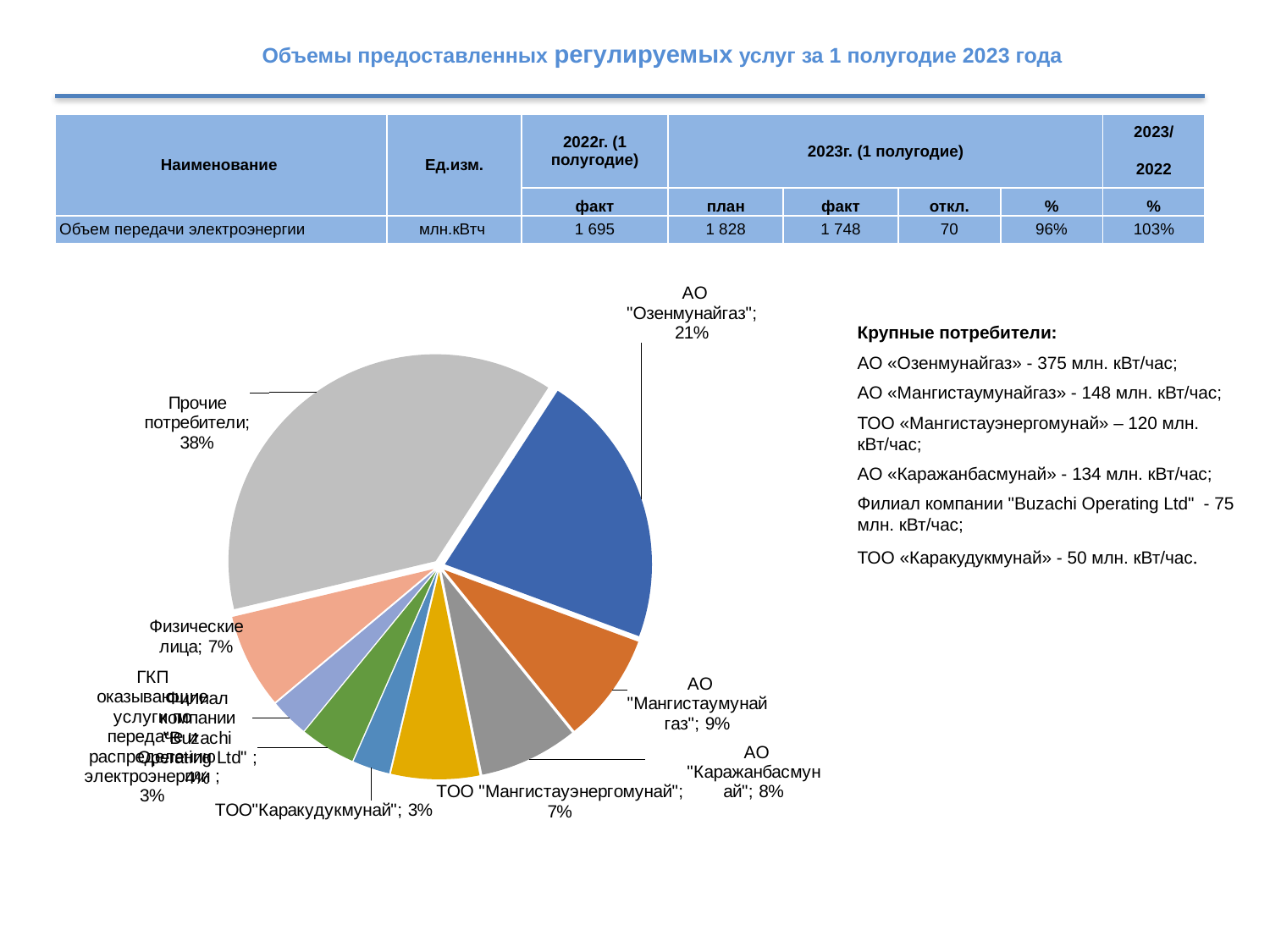
Which is larger: the share of АО "Озенмунайгаз" or the share of АО "Мангистаумунайгаз"? АО "Озенмунайгаз" What share of the pie does ТОО "Мангистауэнергомунай" hold? 7% What share of the pie does ТОО "Каракудукмунай" hold? 3% What share of the pie does АО "Каражанбасмунай" hold? 8% What is the difference in percentage points between the share of Прочие потребители and the share of АО "Озенмунайгаз"? 17 How many slices does the pie chart have? 9 Which slice of the pie is the largest? Прочие потребители What kind of chart is shown on the slide? pie chart